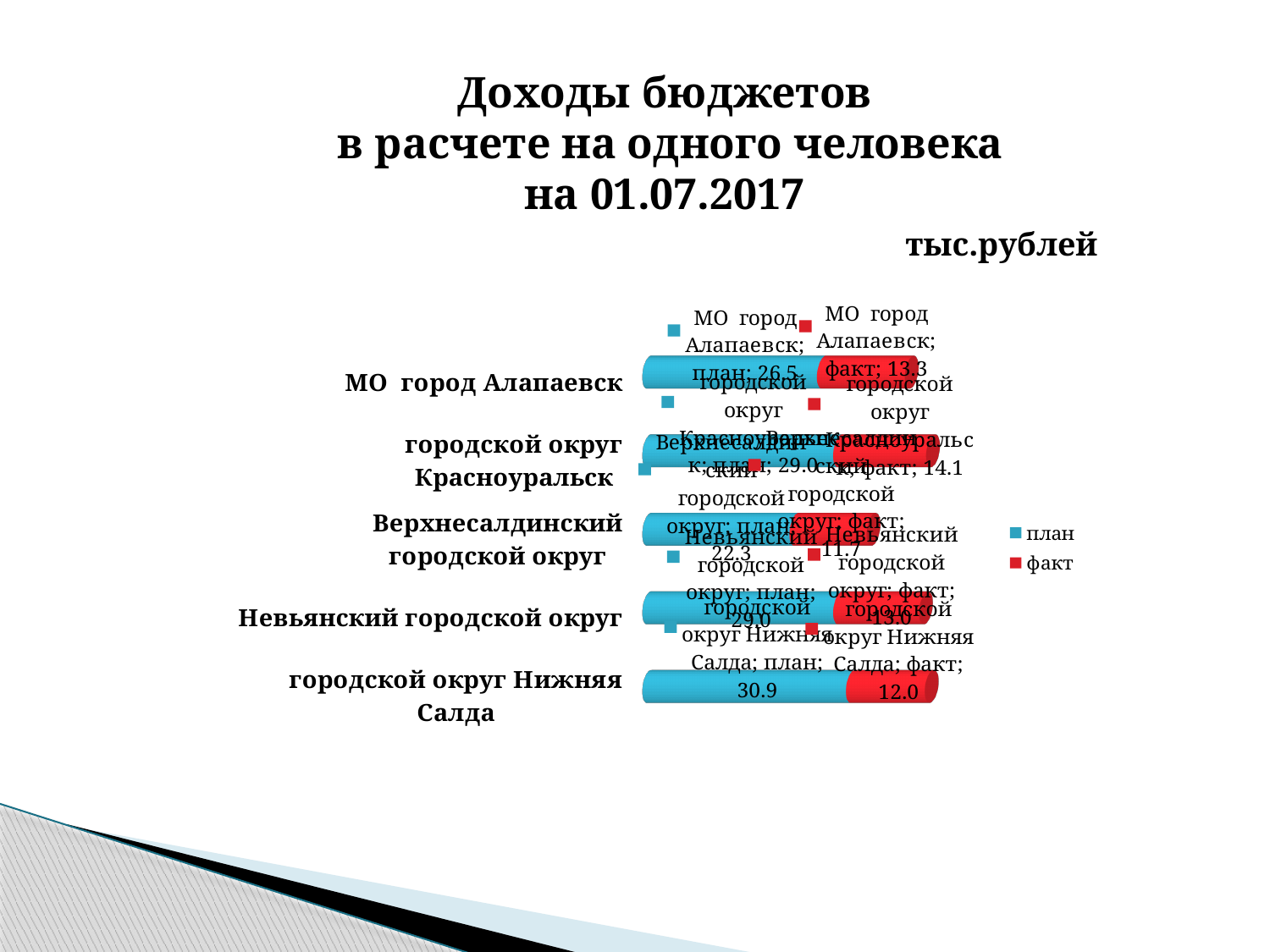
How many categories are shown in the chart? 5 What is the факт value for МО город Алапаевск? 13.3 Which is larger for Невьянский городской округ, план or факт? план What is the факт value for городской округ Красноуральск? 14.1 What kind of chart is shown on the slide? bar chart What is the план value for городской округ Нижняя Салда? 30.9 What is the difference between план and факт for городской округ Нижняя Салда? 18.9 Which category has the highest план value? городской округ Нижняя Салда What is the план value for Верхнесалдинский городской округ? 22.3 How many series does the legend list? 2 Which category has the lowest план value? Верхнесалдинский городской округ Which category has the lowest факт value? Верхнесалдинский городской округ